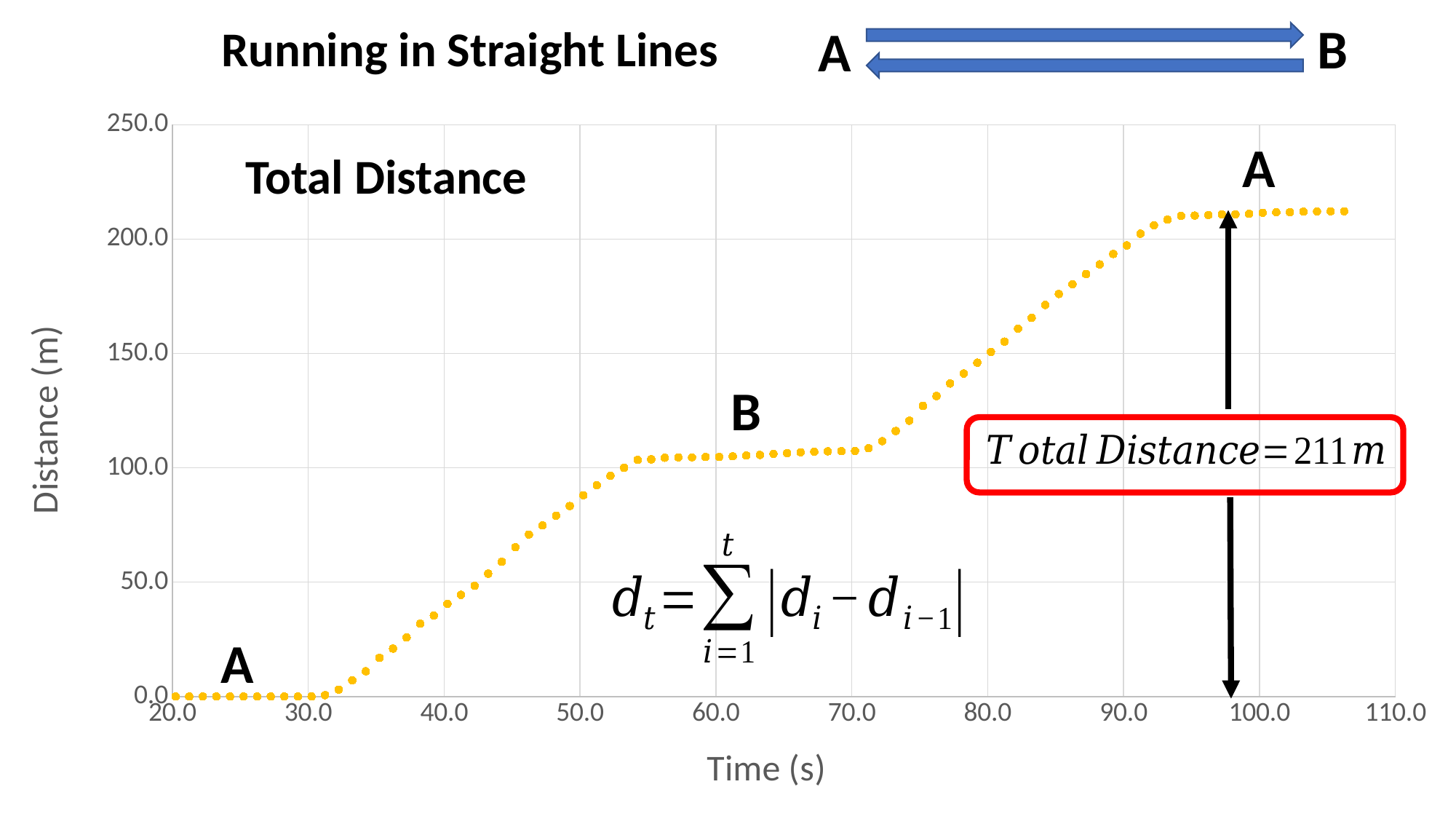
Does the plotted distance rise or fall as time increases along the x axis? rises What is the total distance shown in the red box on the chart? 211 m Is the distance at 80 s greater or less than 100? greater What is the label of the x axis? Time (s) Is the distance at 100 s greater or less than 200? greater Is the distance at 40 s greater or less than 50? less Which is larger, the distance at 60 s or the distance at 90 s? 90 s What is the distance value at 25 s? 0.0 What kind of chart is shown? line chart What is the title of the chart? Total Distance